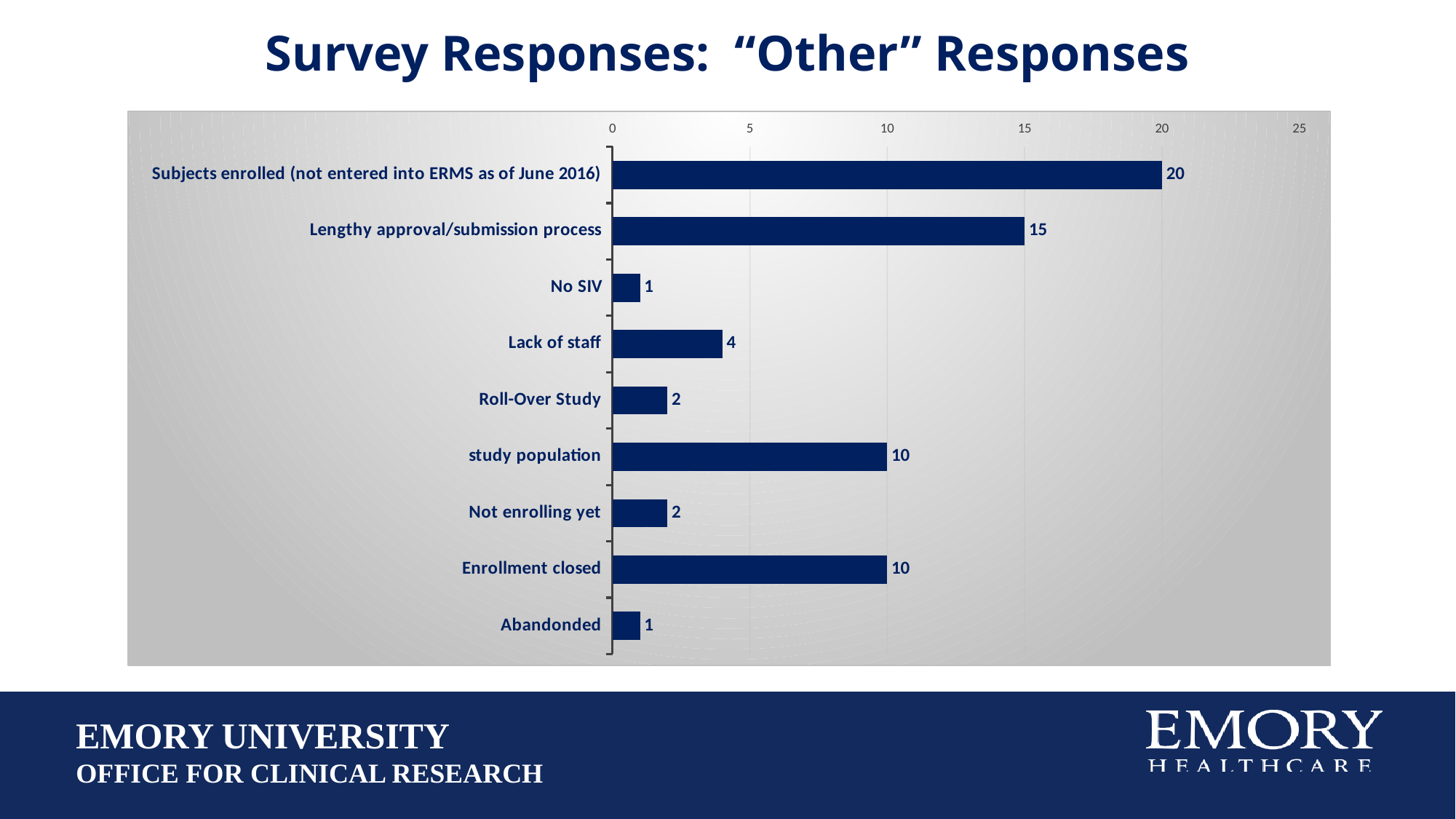
What is the value for "Lack of staff"? 4 What is the value for "Lengthy approval/submission process"? 15 Is the value for "Lengthy approval/submission process" greater or less than 10? greater Which is larger, the value for "Roll-Over Study" or the value for "Lack of staff"? Lack of staff What is the difference between the values for "Subjects enrolled (not entered into ERMS as of June 2016)" and "Lengthy approval/submission process"? 5 What is the value for "No SIV"? 1 What is the value for "study population"? 10 What is the title of the slide? Survey Responses: "Other" Responses What kind of chart is shown on the slide? bar chart Which category has the highest value? Subjects enrolled (not entered into ERMS as of June 2016) What is the difference between the values for "Enrollment closed" and "Lack of staff"? 6 How many categories are shown in the chart? 9